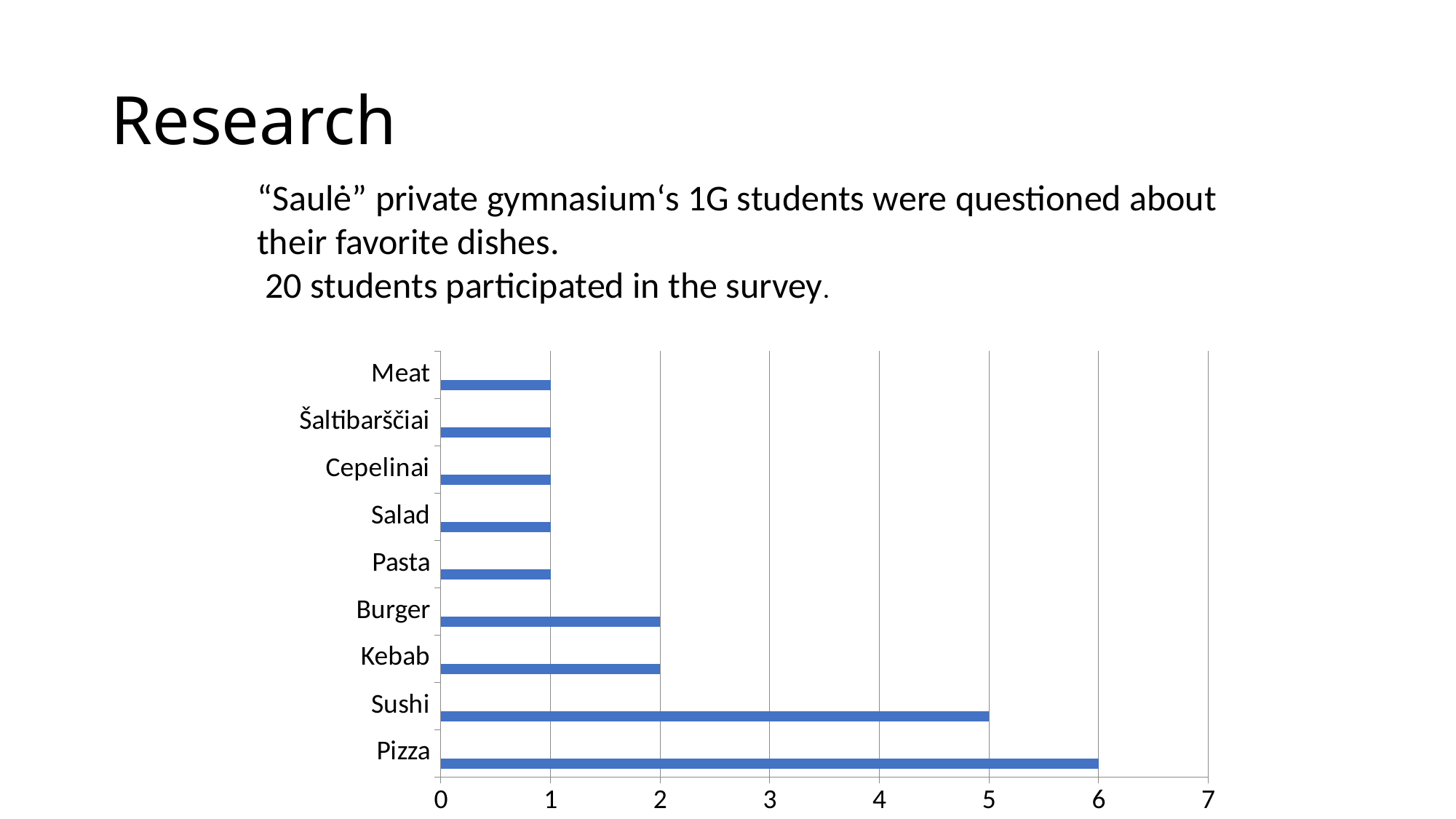
Which dish has the highest value? Pizza What is the highest value shown on the horizontal axis? 7 What is the value for Pasta? 1 What is the difference between the values for Pizza and Sushi? 1 What is the value for Pizza? 6 What is the value for Sushi? 5 What is the difference between the values for Sushi and Burger? 3 How many dishes (categories) are shown in the chart? 9 What is the value for Kebab? 2 Which has a larger value, Burger or Salad? Burger What kind of chart is shown on the slide? bar chart Is the value for Sushi greater or less than 4? greater